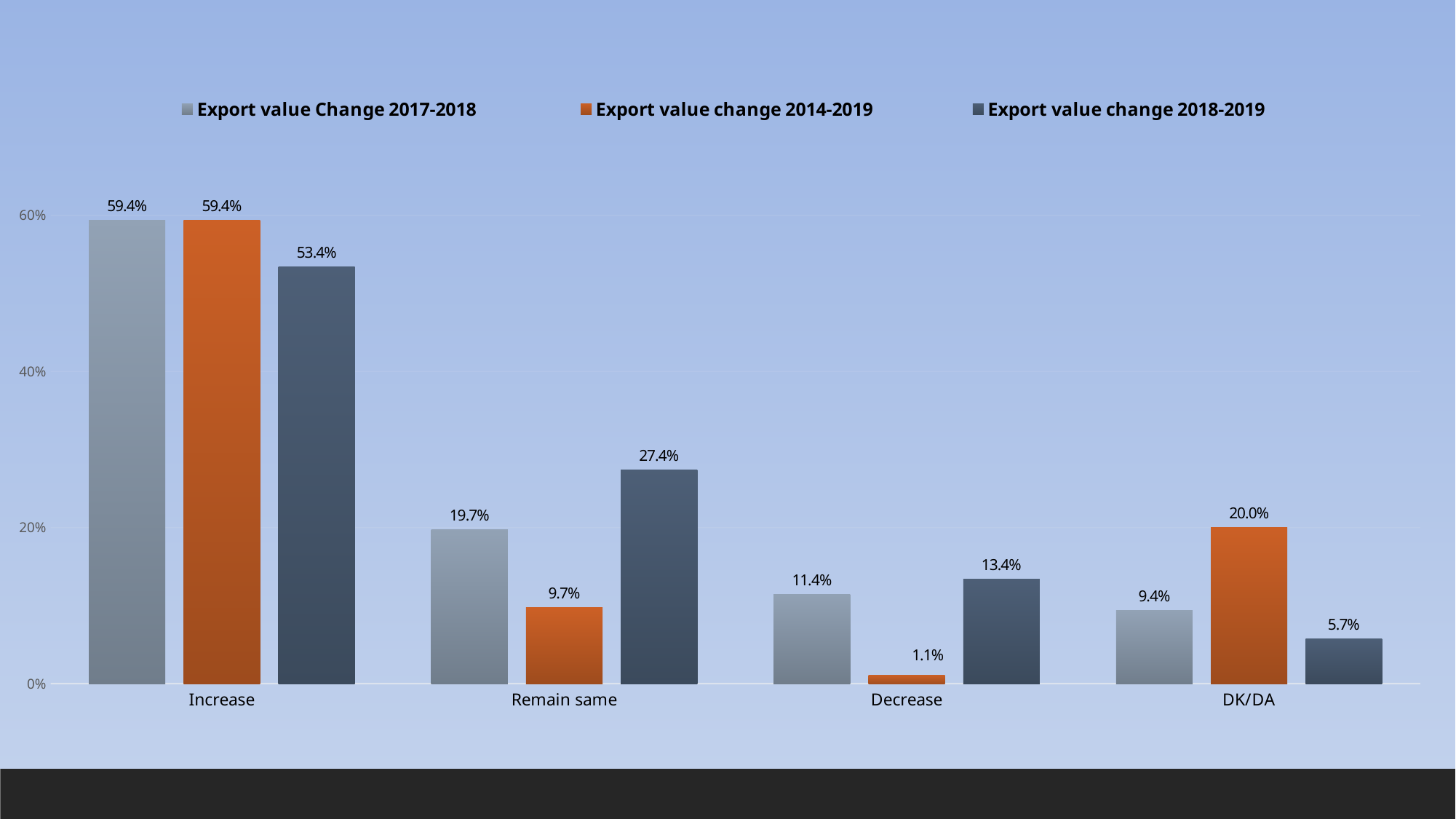
For Decrease, which series has the larger value: Export value Change 2017-2018 or Export value change 2018-2019? Export value change 2018-2019 Which category has the highest value in the Export value change 2018-2019 series? Increase What is the value for DK/DA in the Export value Change 2017-2018 series? 9.4% What is the difference between the Export value change 2014-2019 values for DK/DA and Decrease? 18.9% What is the value for Remain same in the Export value change 2014-2019 series? 9.7% Which category has the lowest value in the Export value change 2014-2019 series? Decrease How many series does the legend list? 3 Which series is shown in orange in the legend? Export value change 2014-2019 What kind of chart is shown on the slide? Bar chart What is the difference between the Export value change 2018-2019 and Export value Change 2017-2018 values for Remain same? 7.7% What is the value for Increase in the Export value change 2018-2019 series? 53.4% How many categories are shown on the x axis? 4